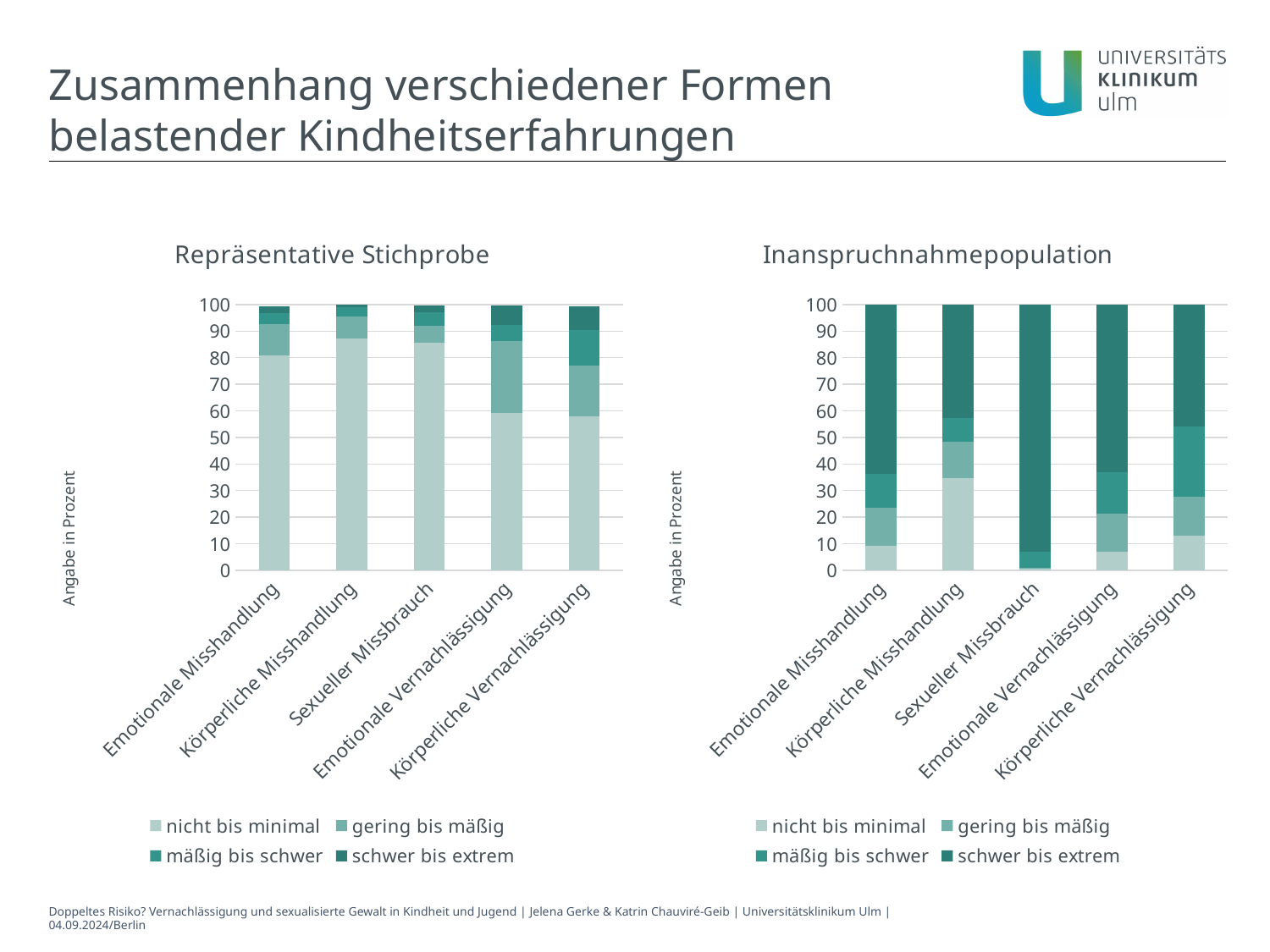
How many categories are shown on the x axis of the 'Inanspruchnahmepopulation' chart? 5 In the 'Inanspruchnahmepopulation' chart, is the 'nicht bis minimal' value for Körperliche Misshandlung greater or less than 40? less How many series does the legend of the 'Repräsentative Stichprobe' chart list? 4 In the 'Repräsentative Stichprobe' chart, which has the larger 'nicht bis minimal' segment: Emotionale Misshandlung or Emotionale Vernachlässigung? Emotionale Misshandlung In the 'Repräsentative Stichprobe' chart, is the 'nicht bis minimal' value for Emotionale Vernachlässigung greater or less than 70? less In the 'Repräsentative Stichprobe' chart, is the 'nicht bis minimal' value for Körperliche Misshandlung greater or less than 80? greater In the 'Inanspruchnahmepopulation' chart, which category has the largest 'nicht bis minimal' segment? Körperliche Misshandlung In the 'Inanspruchnahmepopulation' chart, which category has the largest 'schwer bis extrem' segment? Sexueller Missbrauch What kind of chart is the 'Repräsentative Stichprobe' chart? stacked bar chart What is the y-axis label of the 'Inanspruchnahmepopulation' chart? Angabe in Prozent